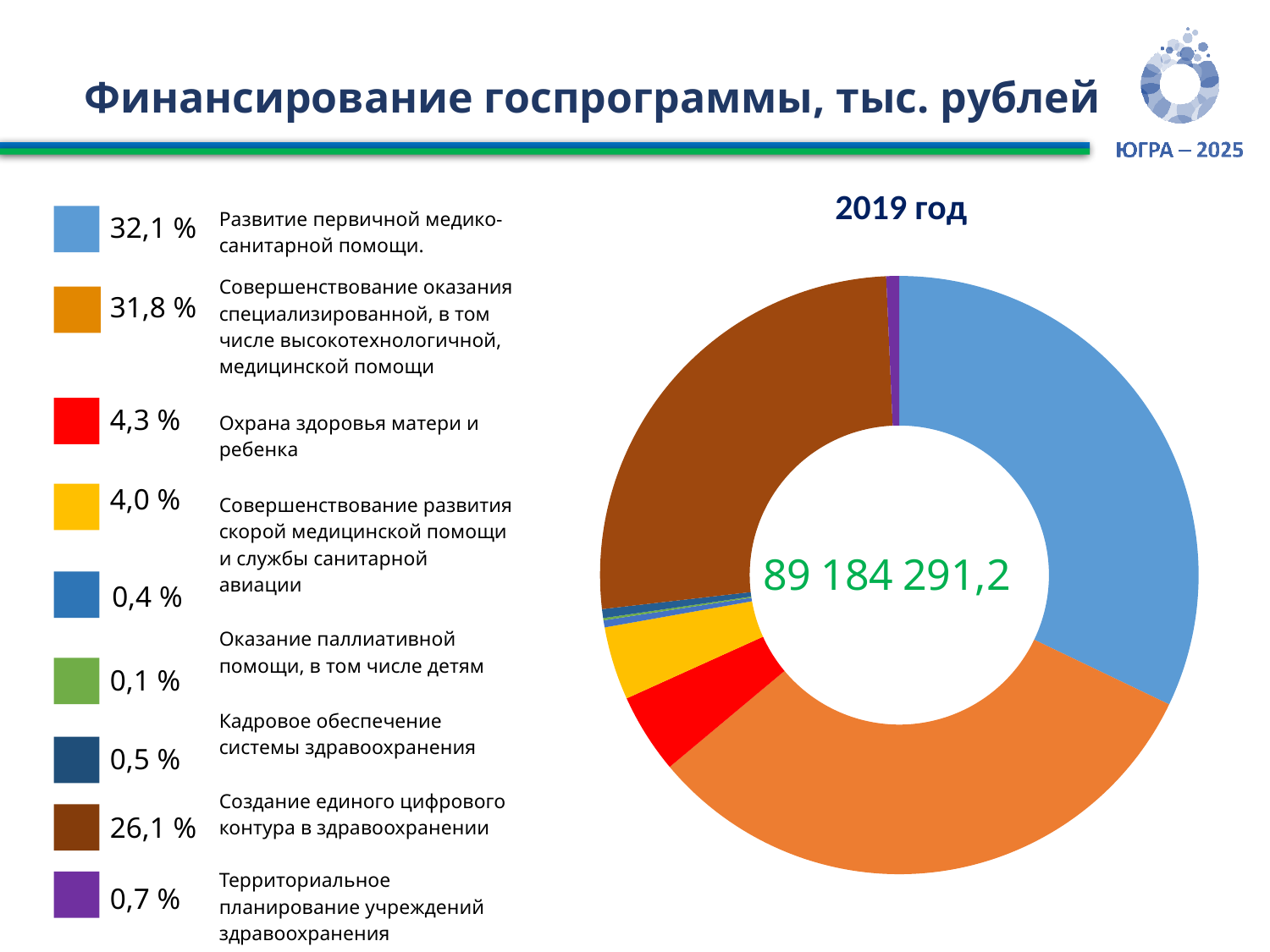
What share of the chart is 'Развитие первичной медико-санитарной помощи'? 32,1 % Which category has the largest share in the chart? Развитие первичной медико-санитарной помощи (32,1 %) What total value is printed in the centre of the doughnut chart? 89 184 291,2 What is the smallest share shown in the legend? 0,1 % How many slices does the doughnut chart have? 9 What is the difference in percentage points between the 32,1 % slice and the 31,8 % slice? 0,3 What kind of chart is shown on the slide? Doughnut (pie) chart What year does the doughnut chart refer to, according to its title? 2019 год What share of the chart is 'Охрана здоровья матери и ребенка'? 4,3 %